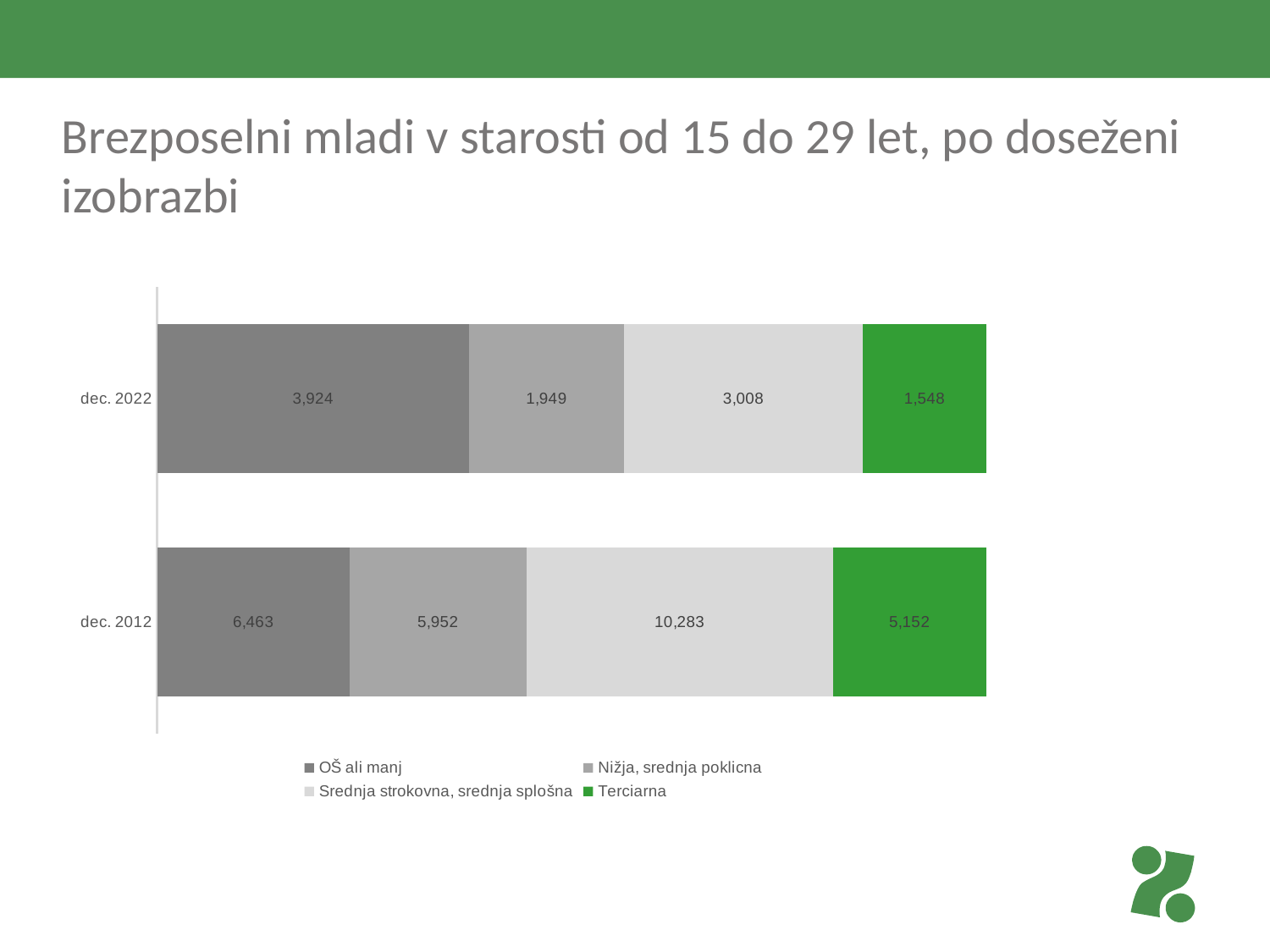
What is the total of the dec. 2012 bar? 27,850 What is the total of the dec. 2022 bar? 10,429 What is the value for Srednja strokovna, srednja splošna in dec. 2022? 3,008 Which is larger: OŠ ali manj in dec. 2012 or OŠ ali manj in dec. 2022? dec. 2012 What is the value for Terciarna in dec. 2012? 5,152 How many series does the legend list? 4 What is the value for OŠ ali manj in dec. 2022? 3,924 Which education group has the lowest value in dec. 2022? Terciarna What is the difference between the Terciarna values for dec. 2012 and dec. 2022? 3,604 What is the value for Nižja, srednja poklicna in dec. 2012? 5,952 Which education group has the highest value in dec. 2012? Srednja strokovna, srednja splošna What kind of chart is shown on the slide? Stacked bar chart